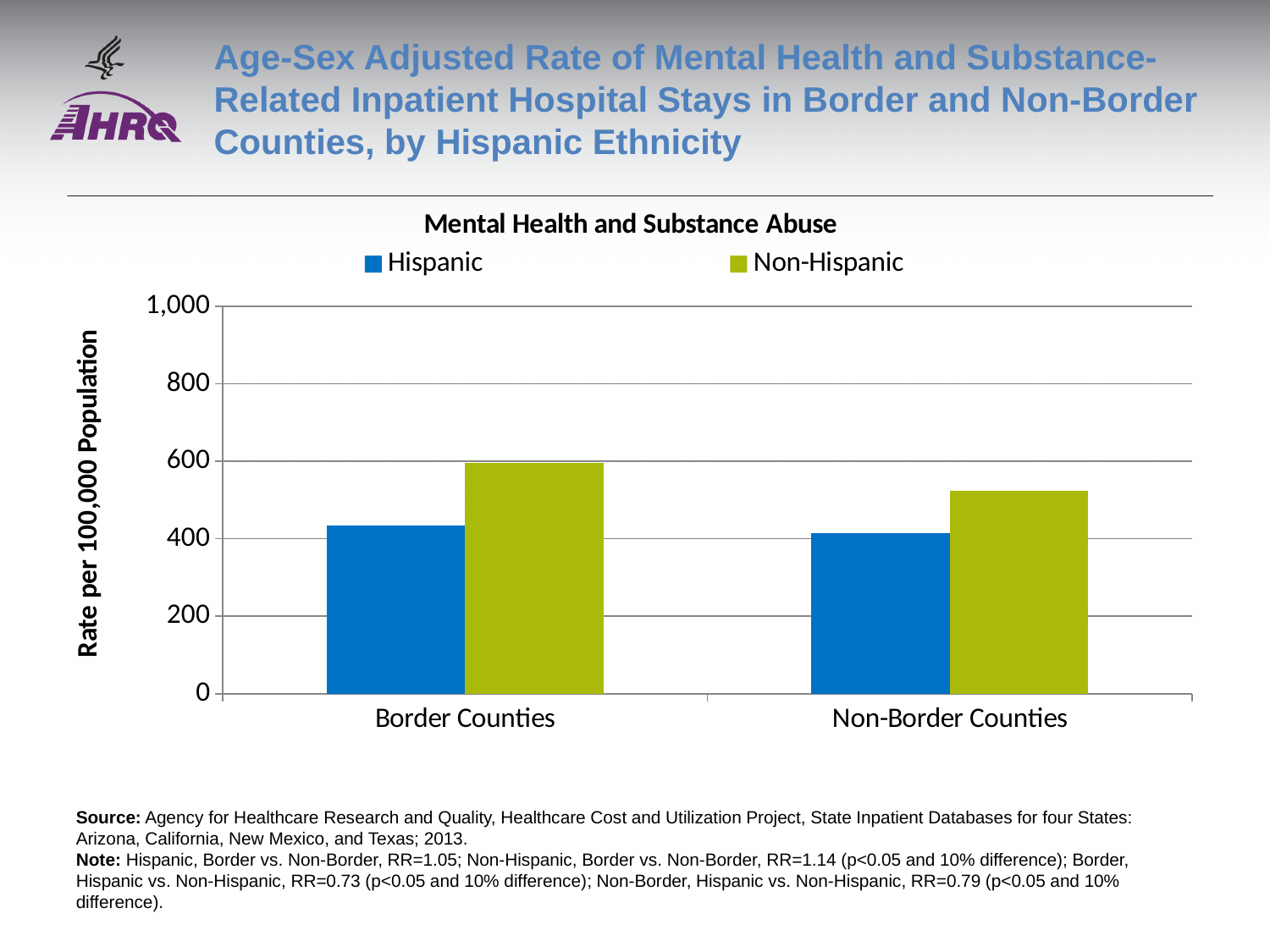
Which bar is the highest in the chart? Non-Hispanic, Border Counties For the Non-Hispanic series, which is larger: Border Counties or Non-Border Counties? Border Counties What is the label of the vertical axis? Rate per 100,000 Population Is the Non-Hispanic value for Non-Border Counties greater or less than 600? less Is the Non-Hispanic value for Border Counties greater or less than 400? greater What kind of chart is shown on the slide? Bar chart What is the title of the chart? Mental Health and Substance Abuse In Non-Border Counties, which is larger: the Hispanic rate or the Non-Hispanic rate? Non-Hispanic Is the Hispanic value for Border Counties greater or less than 600? less How many series does the legend list? 2 How many county categories are shown on the x axis? 2 In Border Counties, which is larger: the Hispanic rate or the Non-Hispanic rate? Non-Hispanic